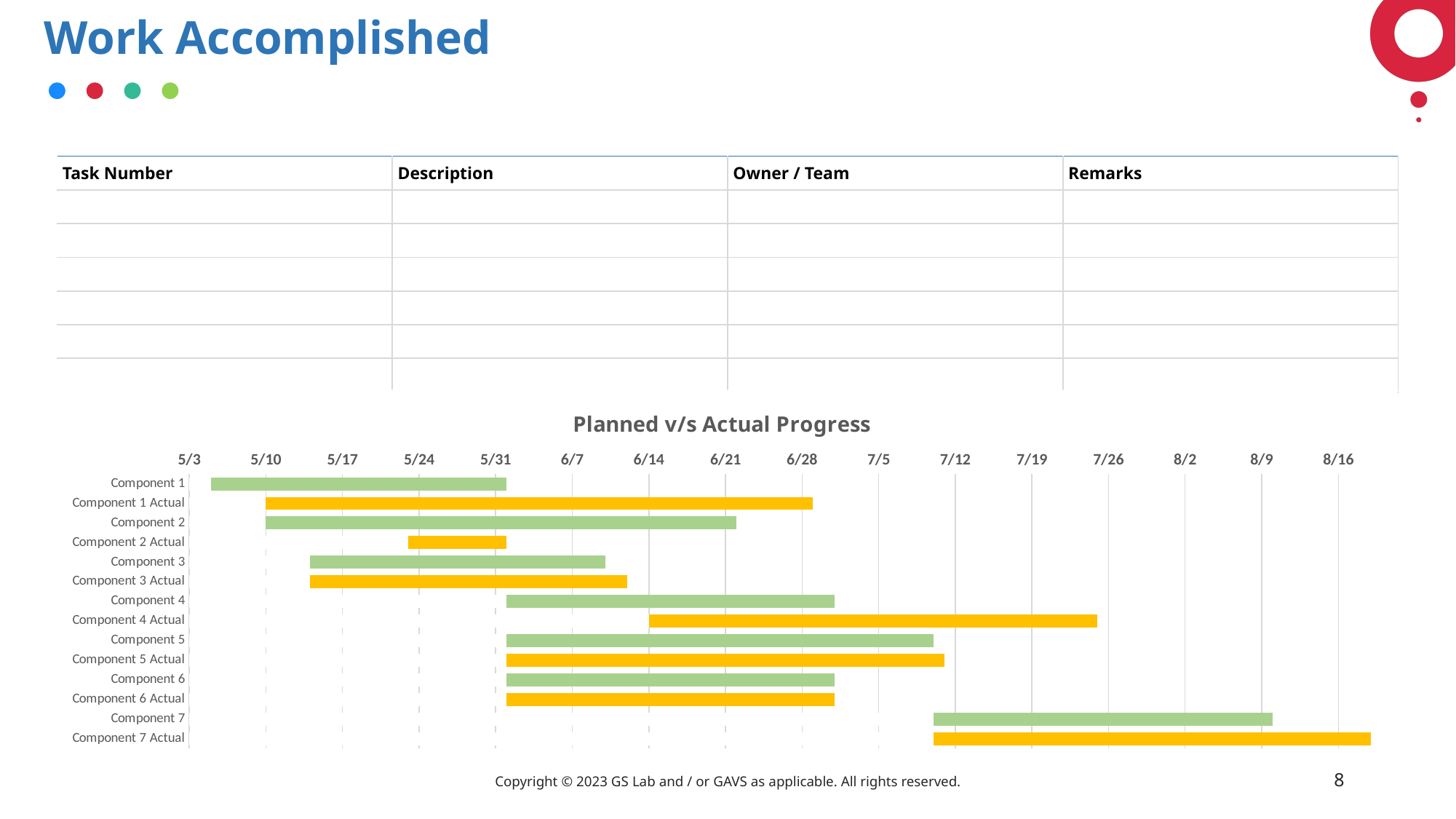
Does the Component 4 Actual bar end before or after 7/19? after What kind of chart is shown on the slide? Bar chart Which bar is longer, Component 7 or Component 7 Actual? Component 7 Actual What colour are the 'Actual' bars in the chart? Orange/yellow What is the title of the chart? Planned v/s Actual Progress On what date does the Component 1 Actual bar start? 5/10 On what date does the Component 4 Actual bar start? 6/14 How many bars (categories) are plotted in the chart? 14 Which bar is the shortest in the chart? Component 2 Actual Which bar is the longest in the chart? Component 1 Actual Which bar is longer, Component 2 or Component 2 Actual? Component 2